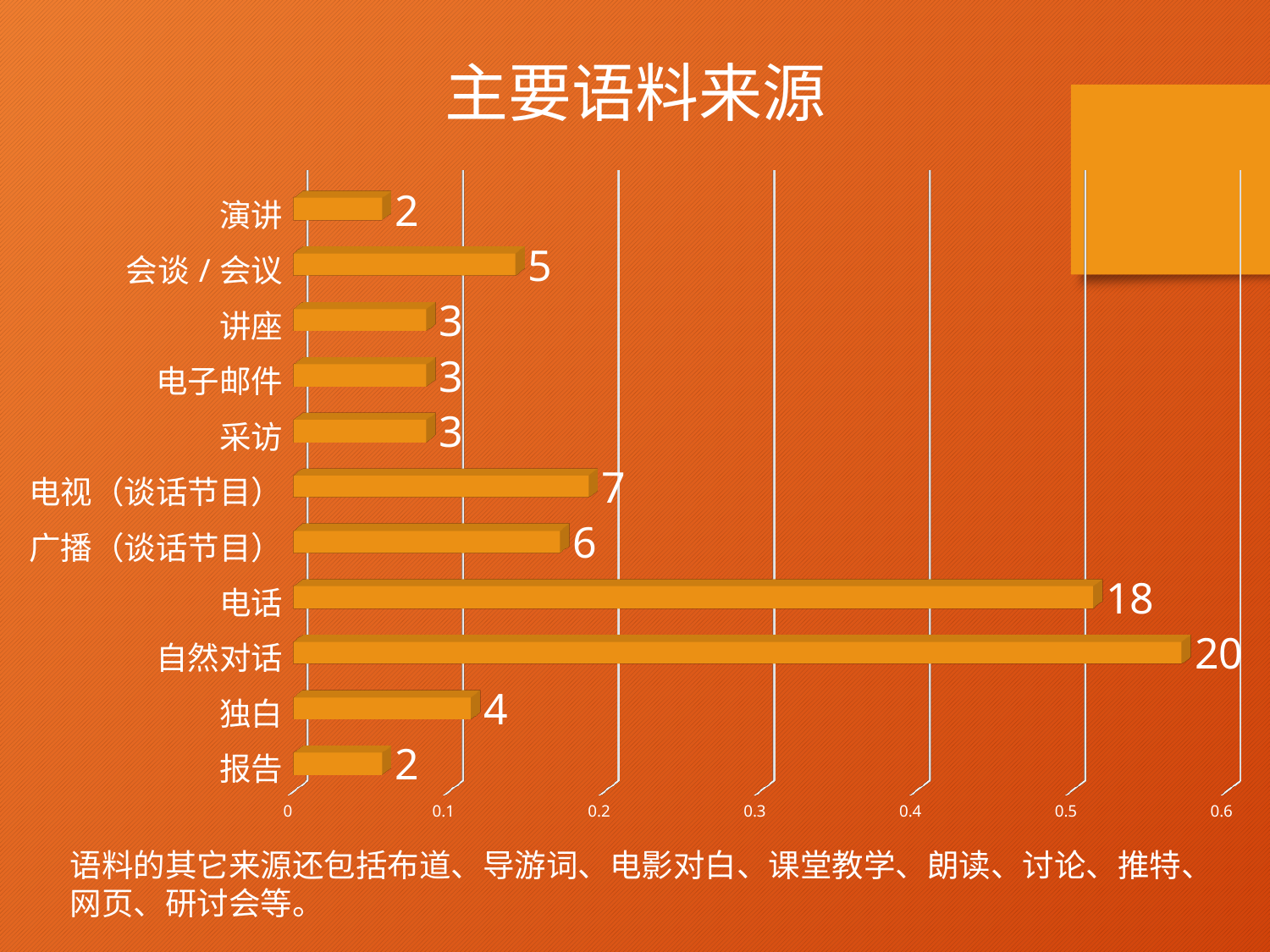
What kind of chart is shown on the slide? bar chart What is the title of the chart? 主要语料来源 What is the value for 独白? 4 Is the bar for 自然对话 greater or less than 0.5 on the axis? greater What is the value for 电话? 18 What is the difference between the values for 自然对话 and 电话? 2 What is the value for 会谈 / 会议? 5 Which has a larger value, 电视（谈话节目） or 广播（谈话节目）? 电视（谈话节目） How many categories are shown in the chart? 11 What is the value for 自然对话? 20 What is the value for 电视（谈话节目）? 7 Which category has the highest value? 自然对话